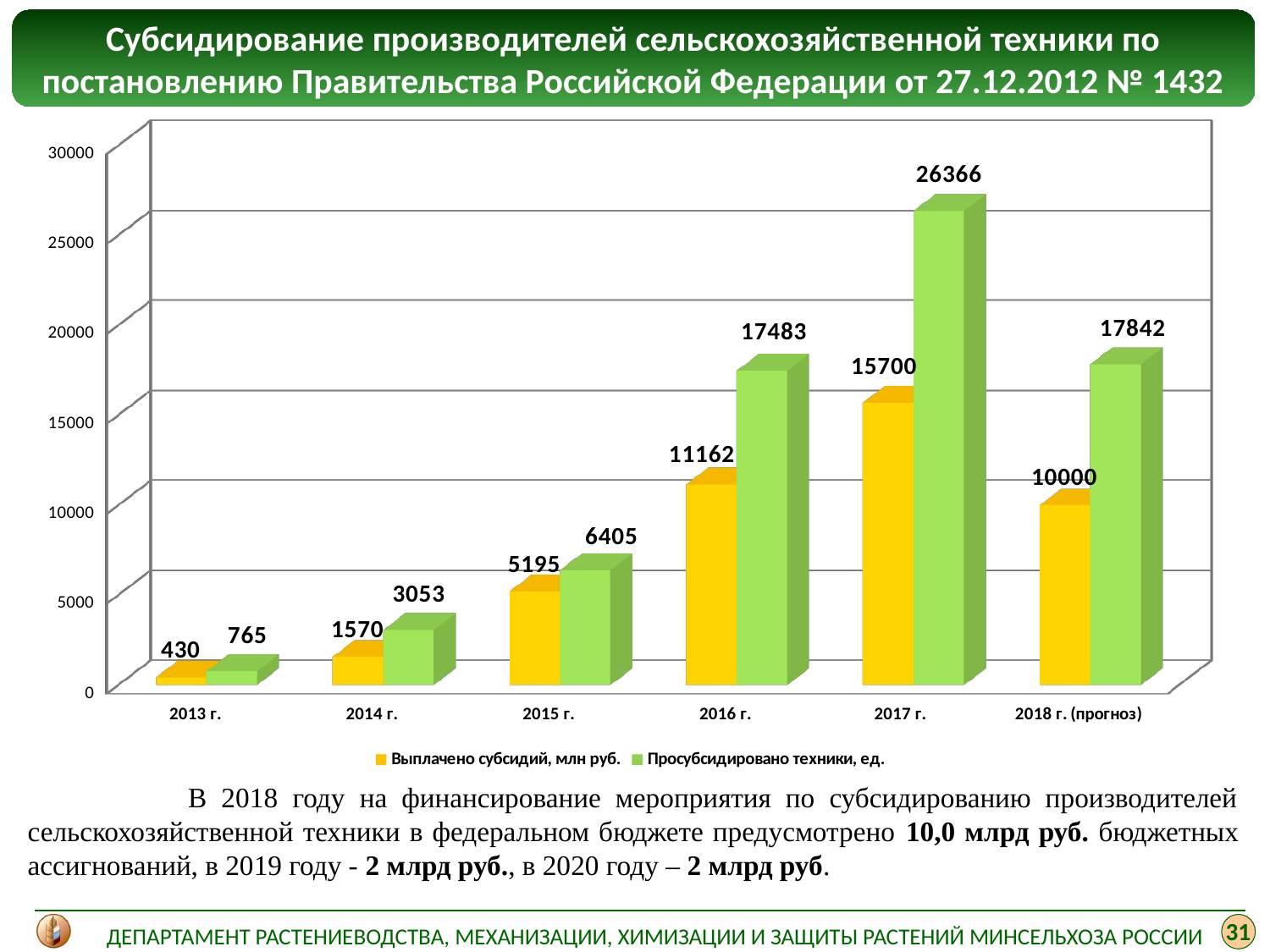
What type of chart is shown on the slide? bar chart How many year categories are shown on the x axis of the chart? 6 What is the difference between "Просубсидировано техники, ед." in 2017 г. and in 2018 г. (прогноз)? 8524 Does the value of "Выплачено субсидий, млн руб." rise or fall from 2013 г. to 2017 г.? rise What is the value of "Выплачено субсидий, млн руб." for 2018 г. (прогноз)? 10000 In which year is the value of "Просубсидировано техники, ед." highest? 2017 г. What is the value of "Просубсидировано техники, ед." for 2016 г.? 17483 In which year is the value of "Выплачено субсидий, млн руб." lowest? 2013 г. What colour are the bars for "Просубсидировано техники, ед."? green How many series does the chart legend list? 2 What is the value of "Выплачено субсидий, млн руб." for 2017 г.? 15700 Which is larger: "Выплачено субсидий, млн руб." in 2016 г. or in 2018 г. (прогноз)? 2016 г.